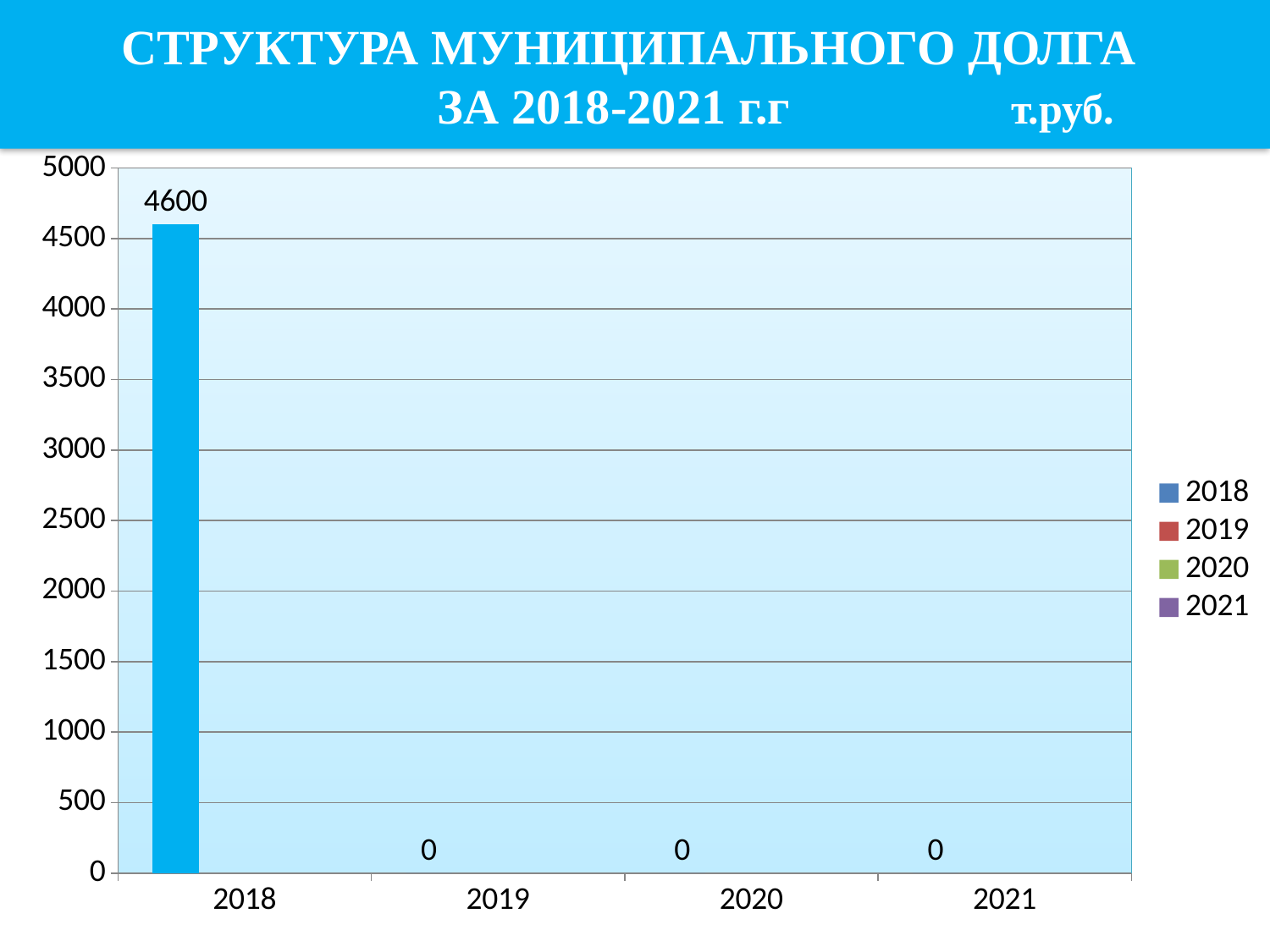
How many years are shown on the x axis? 4 What kind of chart is shown on the slide? bar chart What is the value for 2021? 0 How many entries does the legend list? 4 What is the value for 2019? 0 Which is larger, the value for 2018 or the value for 2019? 2018 Which year has the highest value? 2018 Is the value for 2018 greater or less than 4000? greater Do the values rise or fall from 2018 to 2019? fall What is the difference between the values for 2018 and 2020? 4600 What is the value for 2018? 4600 What unit is indicated in the chart title? т.руб.